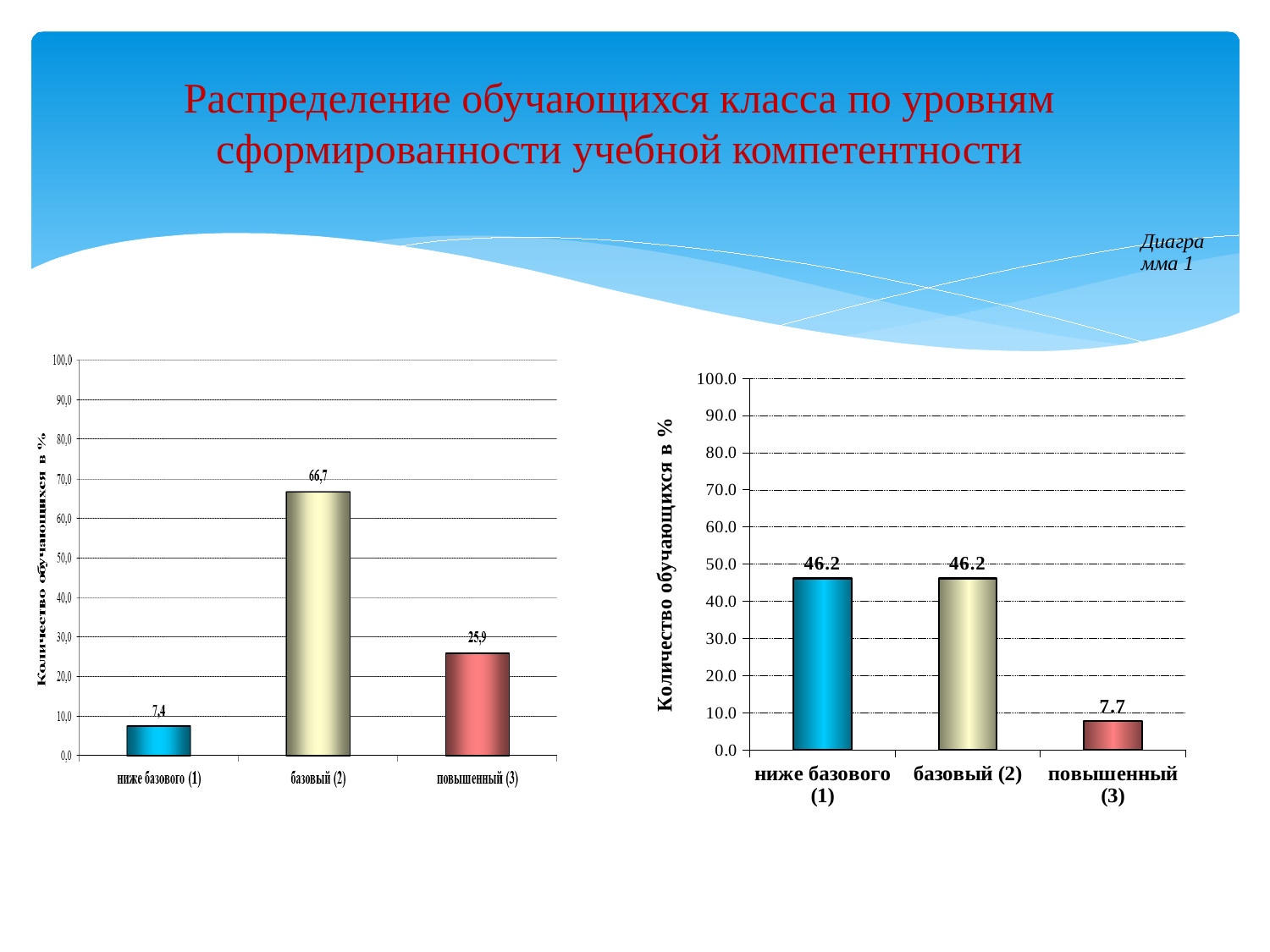
In the left chart, what is the difference between the values for базовый (2) and повышенный (3)? 40,8 In the right chart, what is the value for повышенный (3)? 7.7 How many categories are shown on the x axis of the right chart? 3 In the right chart, is the value for базовый (2) greater or less than 50.0? less In the left chart, what is the value for базовый (2)? 66,7 In the left chart, what is the value for ниже базового (1)? 7,4 In the left chart, which category has the highest value? базовый (2) In the left chart, which category has the lowest value? ниже базового (1) In the right chart, what is the value for ниже базового (1)? 46.2 What type of chart is the left chart? bar chart In the right chart, which category has the lowest value? повышенный (3) In the left chart, what is the value for повышенный (3)? 25,9